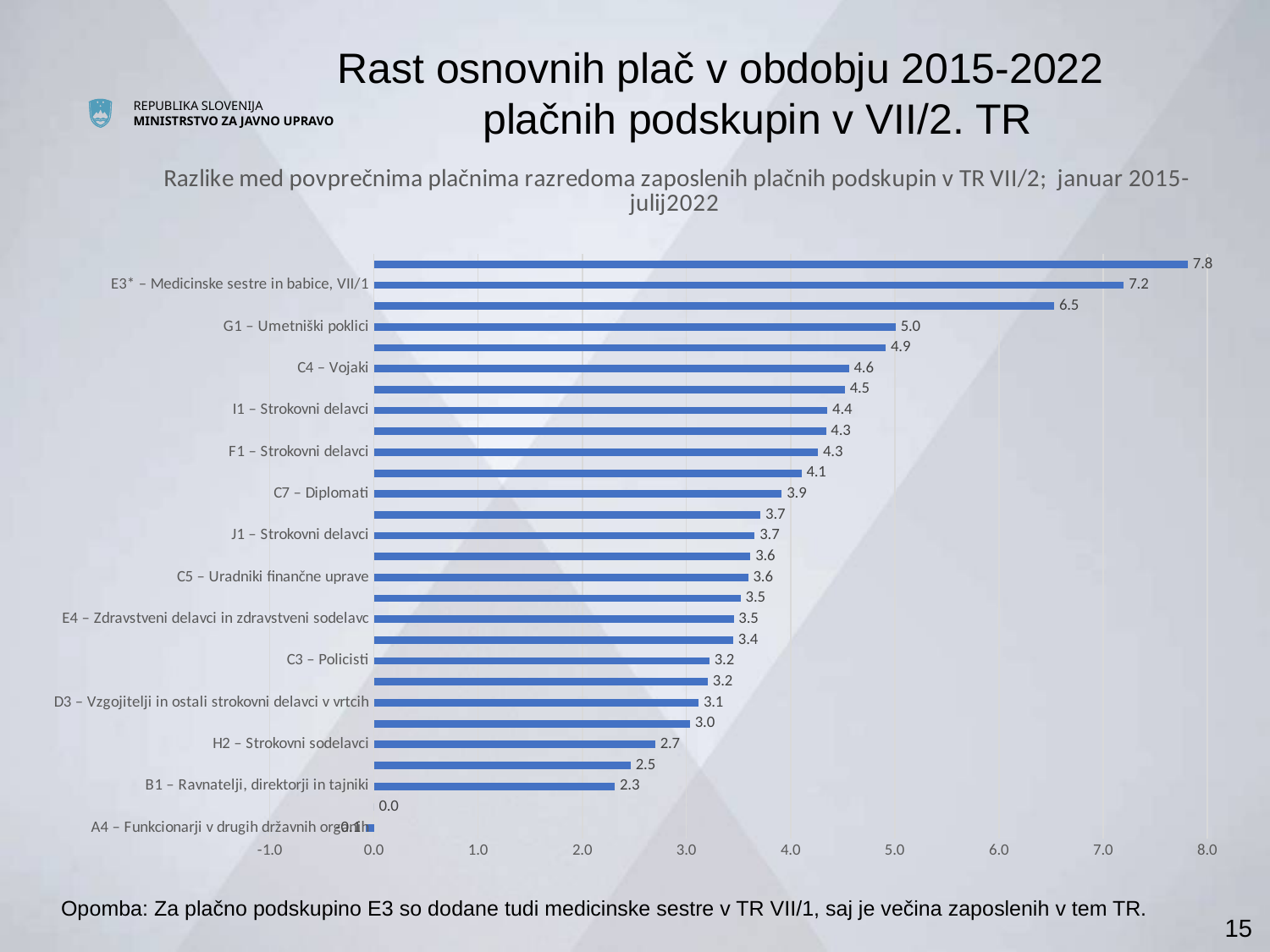
What kind of chart is shown on the slide? bar chart What is the difference between the values for E3* – Medicinske sestre in babice, VII/1 and G1 – Umetniški poklici? 2.2 What is the value for D3 – Vzgojitelji in ostali strokovni delavci v vrtcih? 3.1 What is the value for G1 – Umetniški poklici? 5.0 Which has a larger value, C4 – Vojaki or I1 – Strokovni delavci? C4 – Vojaki What is the value for C7 – Diplomati? 3.9 What is the value for C4 – Vojaki? 4.6 What is the value for E3* – Medicinske sestre in babice, VII/1? 7.2 What is the highest value shown on the chart? 7.8 What is the difference between the values for C7 – Diplomati and B1 – Ravnatelji, direktorji in tajniki? 1.6 What is the value for B1 – Ravnatelji, direktorji in tajniki? 2.3 Is the value for H2 – Strokovni sodelavci greater or less than 3.0? less